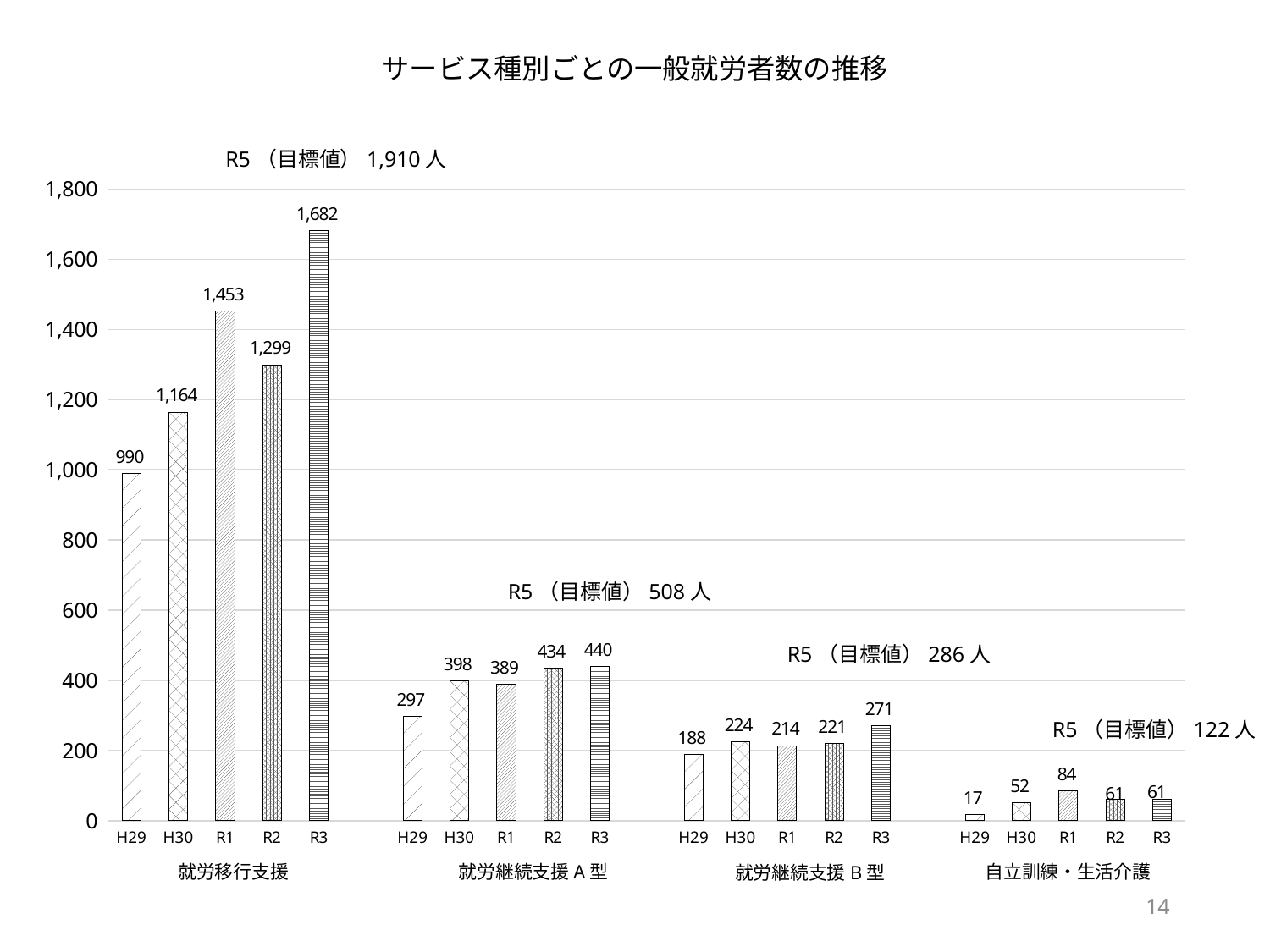
Is the value for R3 in the 就労継続支援Ｂ型 group greater or less than 200? greater Which is larger, the R2 value or the R3 value in the 就労継続支援Ａ型 group? R3 How many bars are plotted in the 就労継続支援Ａ型 group? 5 Which year has the lowest value in the 就労継続支援Ｂ型 group? H29 Do the values in the 就労継続支援Ｂ型 group rise or fall from R2 to R3? rise What is the value for R1 in the 自立訓練・生活介護 group? 84 What is the R5 target value (目標値) shown for the 就労継続支援Ａ型 group? 508人 What kind of chart is shown on the slide? bar chart Which year has the highest value in the 就労移行支援 group? R3 What is the difference between the R1 and R2 values in the 就労移行支援 group? 154 What is the value for H29 in the 就労継続支援Ａ型 group? 297 What is the value for R3 in the 就労移行支援 group? 1,682